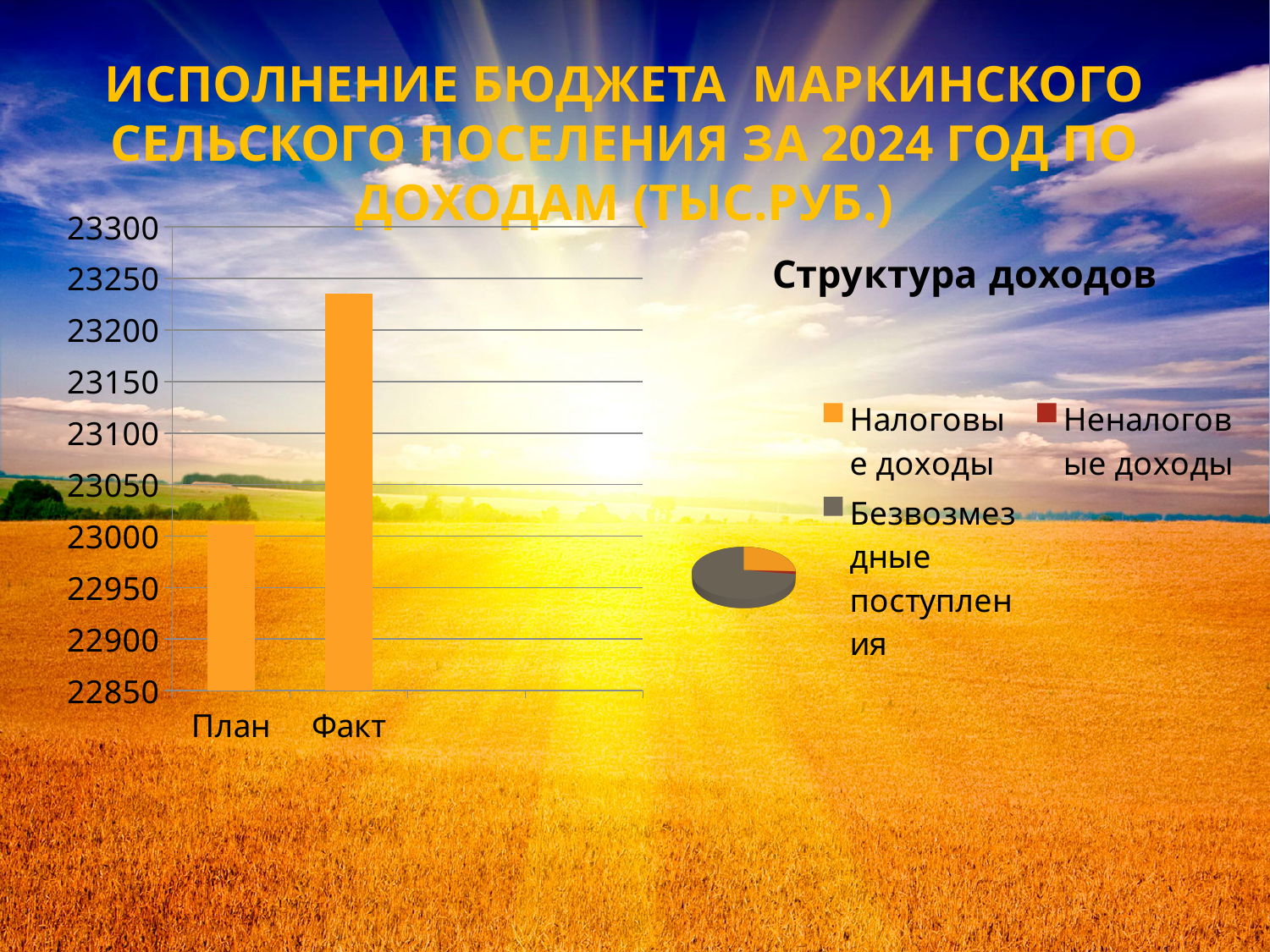
In the pie chart titled 'Структура доходов', which category has the largest slice? Безвозмездные поступления In the bar chart on the left, is the value for Факт greater or less than 23200? greater What is the title of the pie chart on the right of the slide? Структура доходов In the bar chart on the left, which category has the higher value, План or Факт? Факт In the bar chart on the left, is the value for Факт greater or less than 23250? less In the pie chart titled 'Структура доходов', which category has the smallest slice? Неналоговые доходы How many entries does the legend of the chart titled 'Структура доходов' list? 3 In the bar chart on the left, is the value for План greater or less than 23050? less What kind of chart is the chart titled 'Структура доходов'? pie chart What kind of chart is the chart on the left of the slide with the categories План and Факт? bar chart In the bar chart on the left, which category has the lowest value? План In the bar chart on the left, how many categories are shown on the x axis? 2